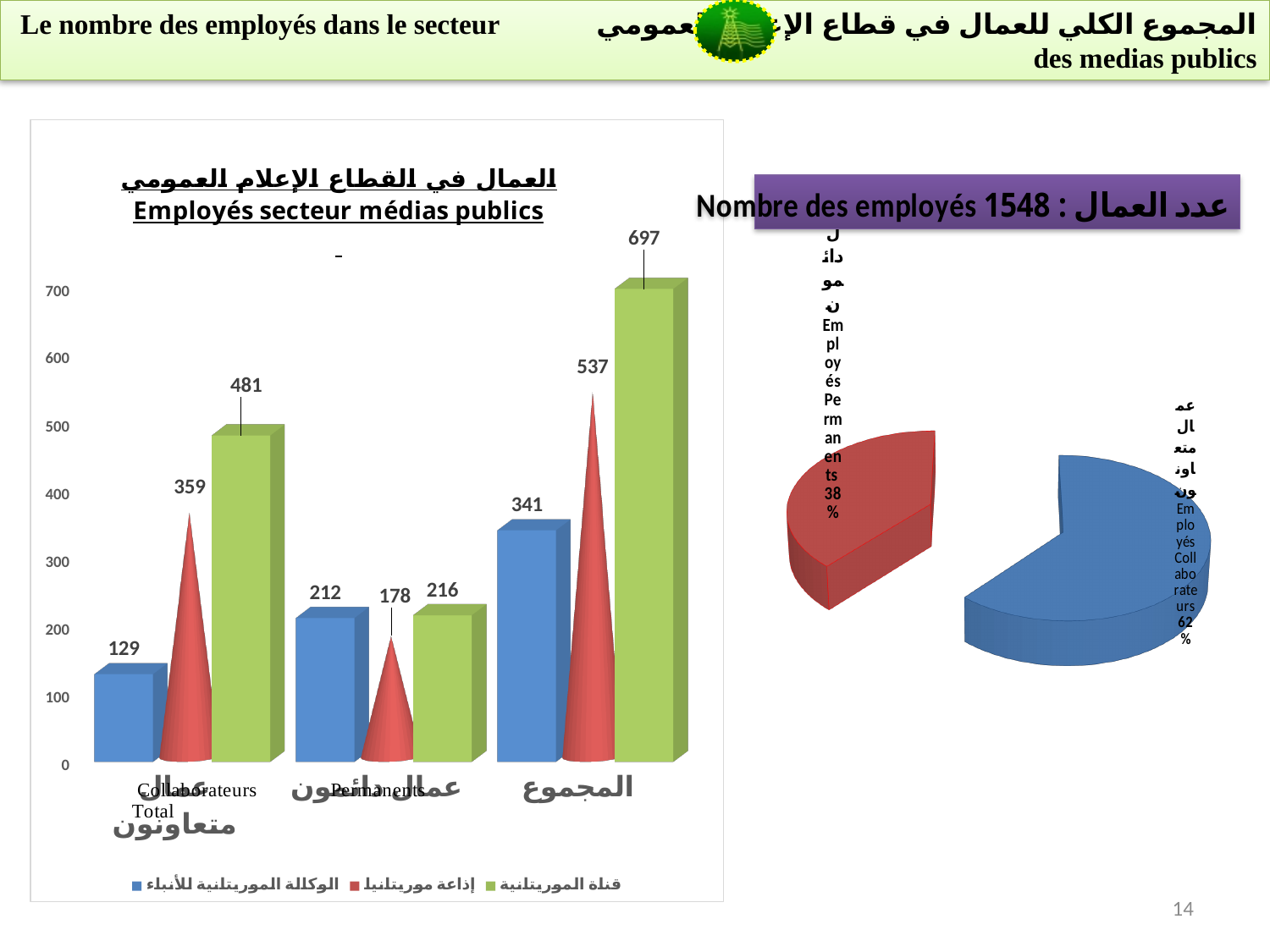
In the pie chart titled "Nombre des employés 1548", what share is shown for Employés Permanents? 38% In the bar chart titled "Employés secteur médias publics", which series has the highest value for Collaborateurs? قناة الموريتانية In the bar chart titled "Employés secteur médias publics", what is the difference between the green series values for Total and Collaborateurs? 216 What kind of chart is the chart on the right titled "Nombre des employés 1548"? Pie chart In the pie chart titled "Nombre des employés 1548", what share is shown for Employés Collaborateurs? 62% How many series does the legend of the bar chart titled "Employés secteur médias publics" list? 3 In the bar chart titled "Employés secteur médias publics", which is larger for Permanents: the blue series (212) or the green series (216)? The green series (216) How many categories are shown on the x axis of the bar chart titled "Employés secteur médias publics"? 3 In the bar chart titled "Employés secteur médias publics", what is the value of the red series (إذاعة موريتانيا) for Permanents? 178 In the bar chart titled "Employés secteur médias publics", which series has the lowest value for Total? الوكالة الموريتانية للأنباء